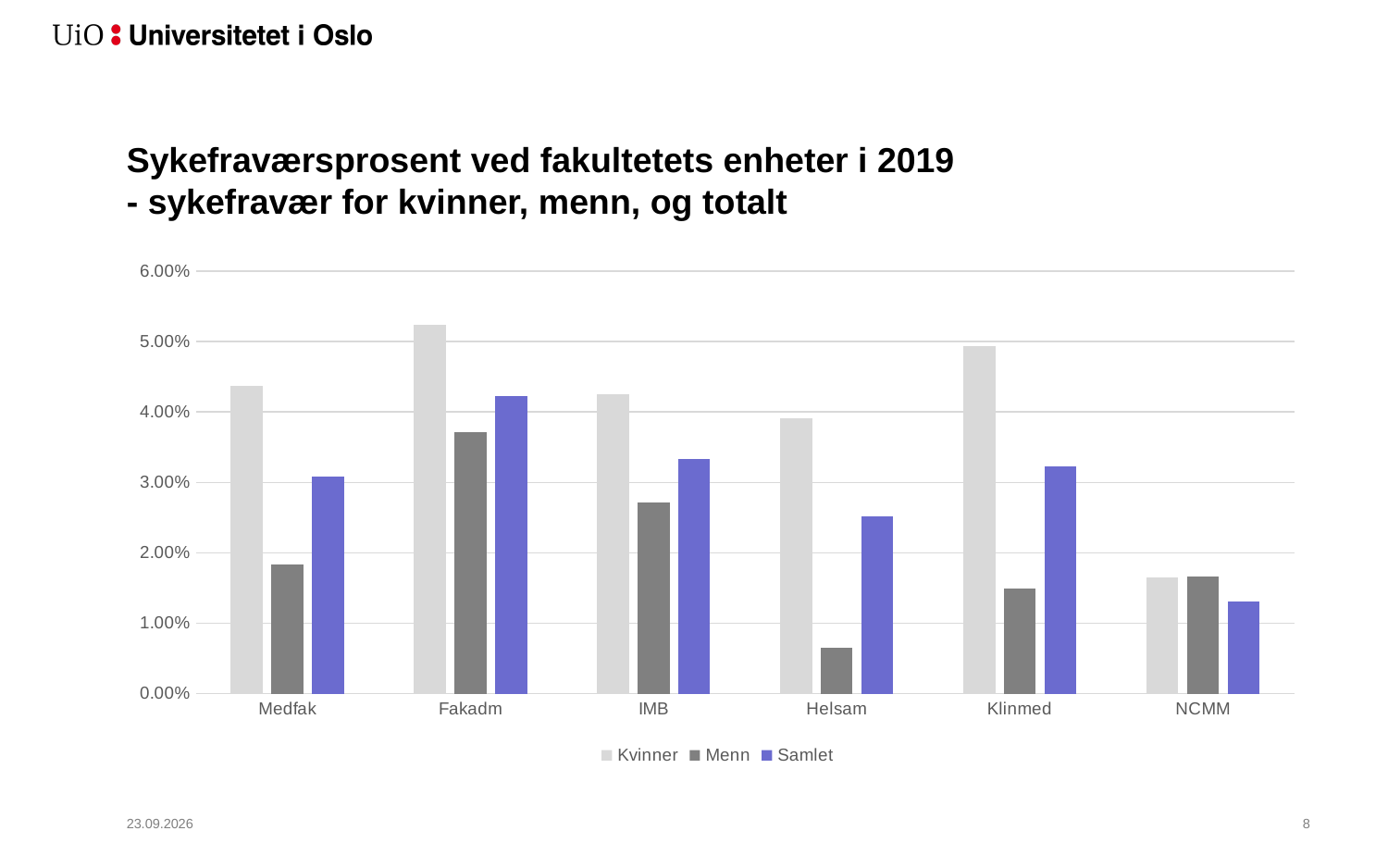
Is the Menn value for Helsam greater or less than 1.00%? less What kind of chart is shown on the slide? bar chart Which unit has the lowest Samlet value? NCMM How many units (categories) are shown on the x axis? 6 Is the Menn value for IMB greater or less than 3.00%? less Is the Kvinner value for Fakadm greater or less than 5.00%? greater Which series is shown in blue in the legend? Samlet Which is larger, the Menn value for Fakadm or the Menn value for IMB? Fakadm How many series does the legend list? 3 Which unit has the highest Kvinner value? Fakadm Which unit has the highest Menn value? Fakadm Which unit has the lowest Menn value? Helsam